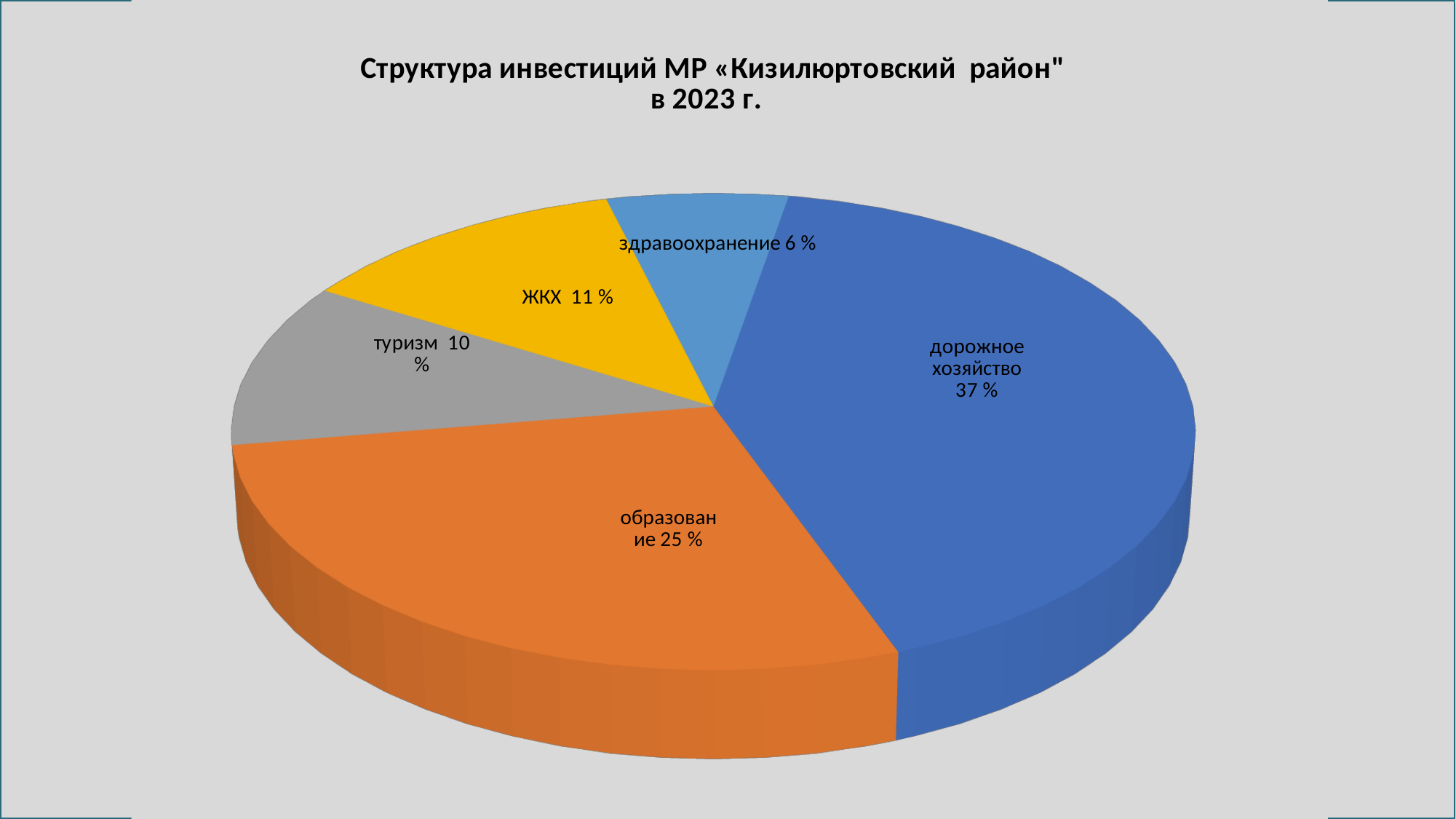
How many categories are shown in the pie chart? 5 What type of chart is shown on the slide? pie chart What share of investments does туризм account for? 10 % What year does the chart title refer to? 2023 What is the difference in percentage points between дорожное хозяйство and образование? 12 Which category has the largest share of investments? дорожное хозяйство What share of investments does дорожное хозяйство account for? 37 % What share of investments does образование account for? 25 % Which has a larger share, ЖКХ or туризм? ЖКХ What share of investments does здравоохранение account for? 6 % What share of investments does ЖКХ account for? 11 % Which category has the smallest share of investments? здравоохранение